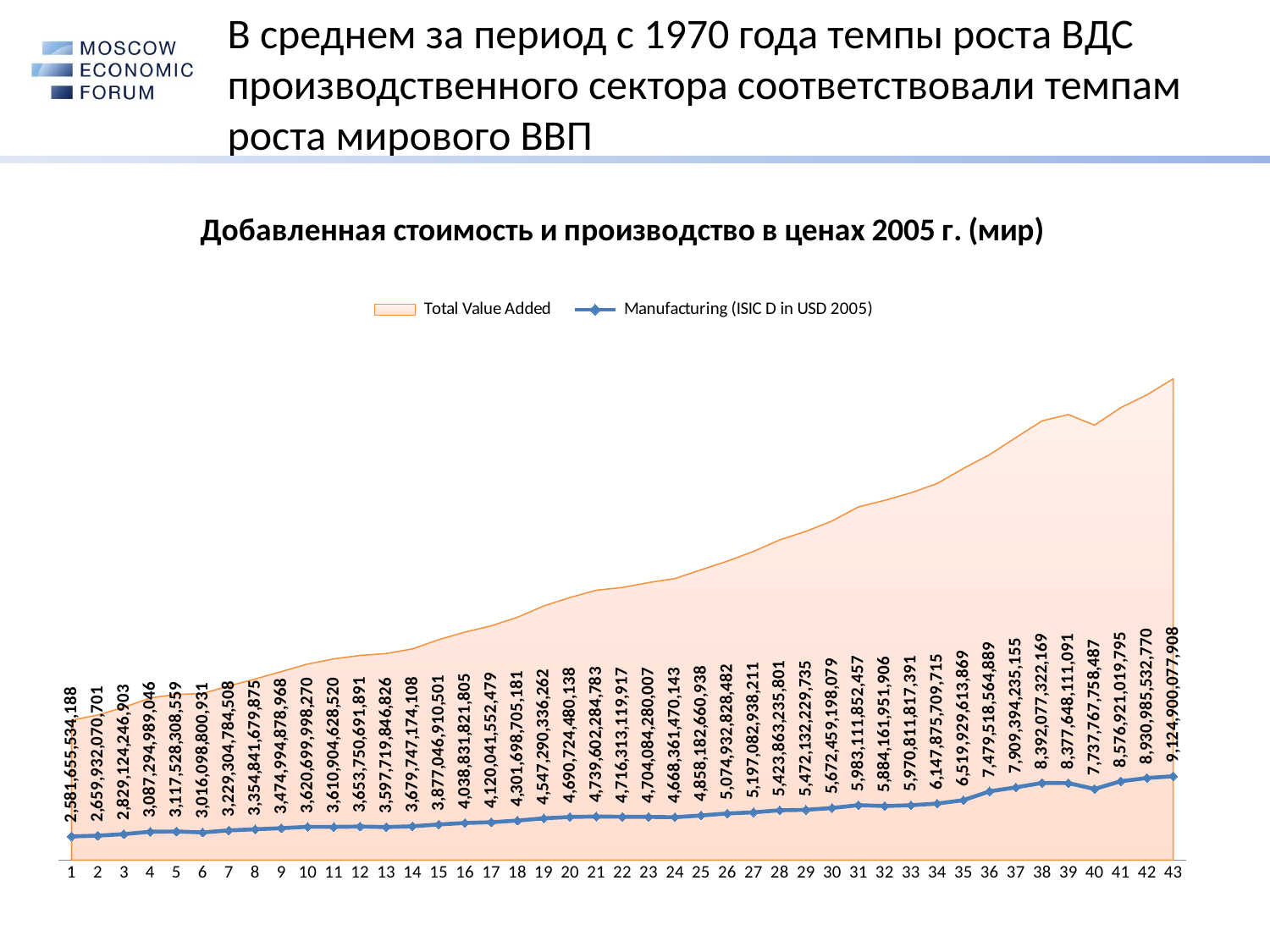
How many series does the chart legend list? 2 What is the Manufacturing (ISIC D in USD 2005) value at point 1? 2,581,655,534,188 Which has the larger Manufacturing (ISIC D in USD 2005) value, point 39 or point 40? Point 39 At which x-axis point is the Manufacturing (ISIC D in USD 2005) value highest? 43 Overall, does the Total Value Added series rise or fall from point 1 to point 43? Rise What is the difference between the Manufacturing values at point 43 and point 42? 193,914,545,138 What is the Manufacturing (ISIC D in USD 2005) value at point 20? 4,690,724,480,138 What is the title of the chart? Добавленная стоимость и производство в ценах 2005 г. (мир) Which series is drawn as a line with markers? Manufacturing (ISIC D in USD 2005) How many points are plotted along the x axis? 43 What is the Manufacturing (ISIC D in USD 2005) value at point 43? 9,124,900,077,908 At which x-axis point is the Manufacturing (ISIC D in USD 2005) value lowest? 1